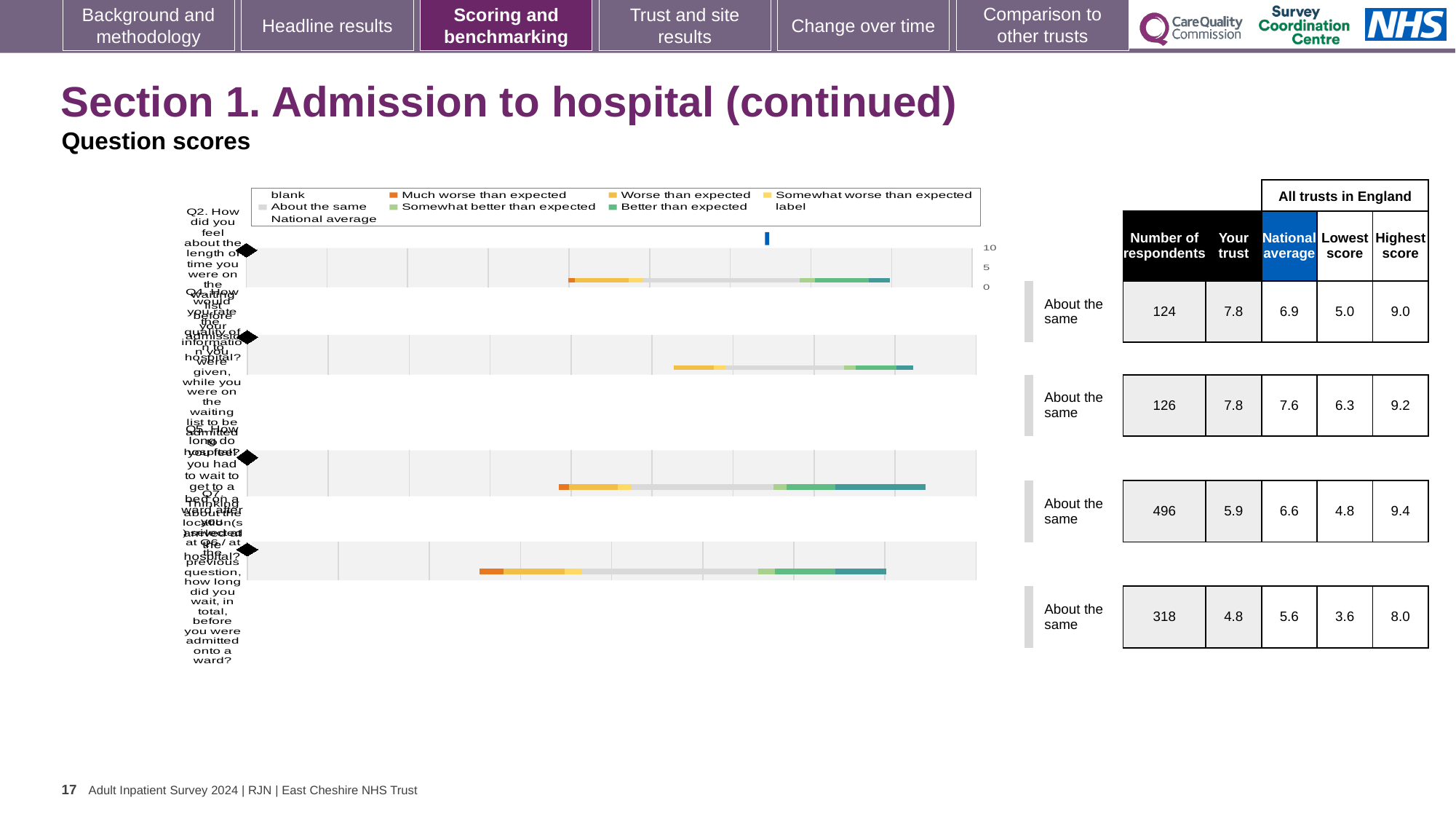
What colour represents 'Much worse than expected' in the chart legend? orange In the table next to the chart, what is the difference between the national average and the 'Your trust' score for Q7? 0.8 How many entries does the chart's legend list? 9 What kind of chart is shown on the slide? bar chart In the table next to the chart, for Q2 is the 'Your trust' score or the national average larger? Your trust In the table next to the chart, which question has the highest 'Highest score' value? Q5 In the table next to the chart, how many respondents are listed for Q2 (length of time on the waiting list)? 124 In the table next to the chart, what is the 'Your trust' score for Q5 (how long you had to wait to get to a bed on a ward)? 5.9 In the table next to the chart, which question has the lowest 'Lowest score' value? Q7 What benchmark category is shown for Q4 (quality of information given while on the waiting list)? About the same How many question rows (bars) does the chart show? 4 What is the highest value shown on the chart's score axis? 10